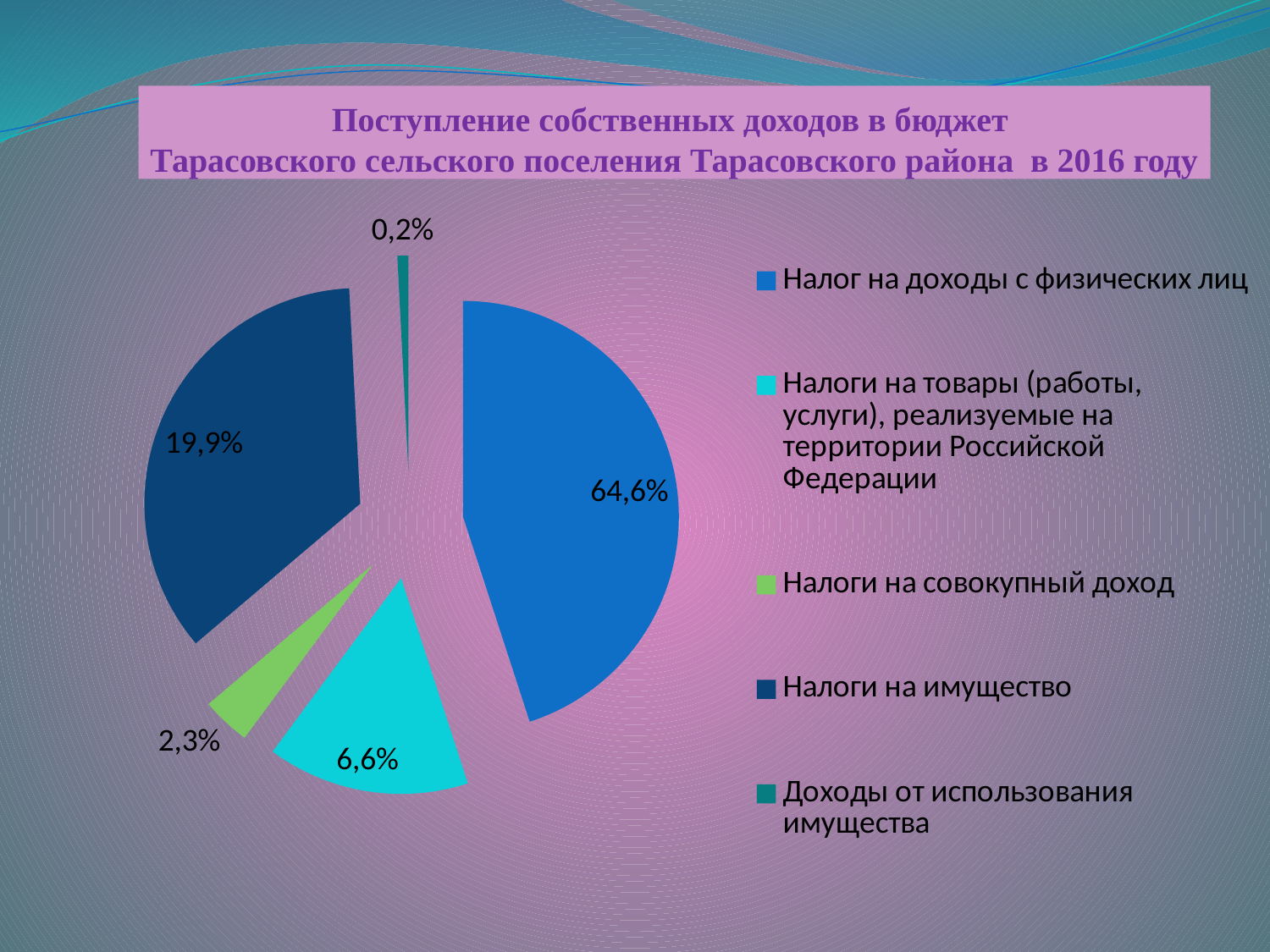
What is the difference between the shares of "Налог на доходы с физических лиц" and "Налоги на имущество"? 44,7% Which category has the smallest slice of the pie? Доходы от использования имущества What is the value shown for "Налоги на имущество"? 19,9% What kind of chart is shown on the slide? pie chart What share of the pie does "Налог на доходы с физических лиц" have? 64,6% What colour is the slice for "Налоги на совокупный доход"? green What is the value shown for "Доходы от использования имущества"? 0,2% How many categories does the pie chart have? 5 What is the value shown for "Налоги на товары (работы, услуги), реализуемые на территории Российской Федерации"? 6,6% Which is larger: the share for "Налоги на товары (работы, услуги), реализуемые на территории Российской Федерации" or for "Налоги на совокупный доход"? Налоги на товары (работы, услуги), реализуемые на территории Российской Федерации Which category has the largest slice of the pie? Налог на доходы с физических лиц What is the value shown for "Налоги на совокупный доход"? 2,3%